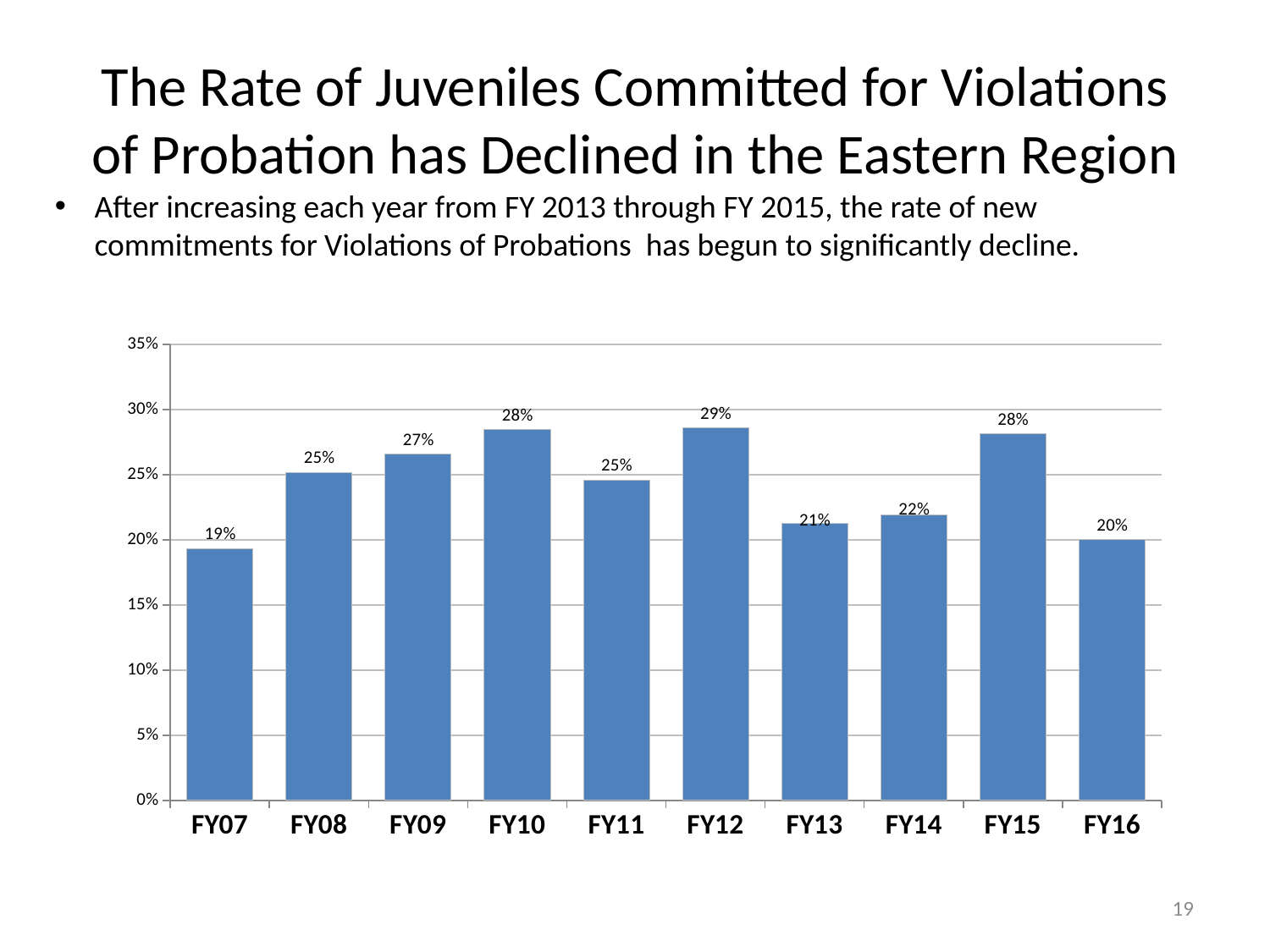
Is the value for FY10 greater or less than 25%? greater What kind of chart is shown on the slide? bar chart Which fiscal year has the lowest value? FY07 What is the difference between the values for FY15 and FY16? 8 percentage points Do the values rise or fall from FY13 to FY15? rise What is the value for FY16? 20% What is the value for FY12? 29% What is the difference between the values for FY12 and FY07? 10 percentage points Which is larger, the value for FY09 or the value for FY13? FY09 Which fiscal year has the highest value? FY12 How many fiscal years are shown on the x axis? 10 What is the value for FY07? 19%